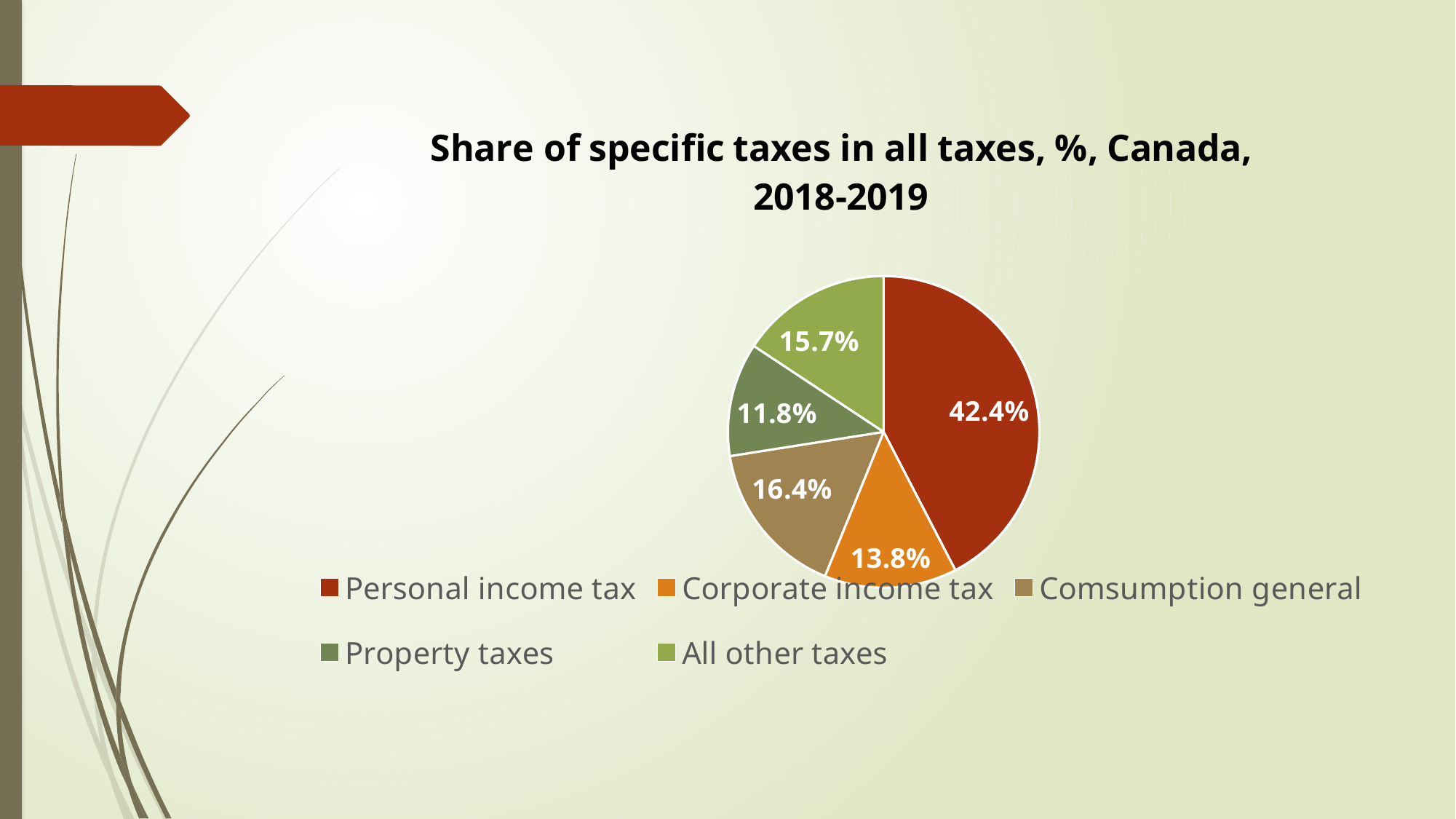
What is the share of Personal income tax? 42.4% What is the share of Corporate income tax? 13.8% What is the difference in percentage points between Personal income tax and Corporate income tax? 28.6 What is the share of All other taxes? 15.7% How many slices does the pie chart have? 5 What kind of chart is shown on the slide? pie chart What is the share of Comsumption general? 16.4% What is the title of the chart? Share of specific taxes in all taxes, %, Canada, 2018-2019 Which tax category has the smallest share? Property taxes Which has a larger share, Comsumption general or All other taxes? Comsumption general Which tax category has the largest share? Personal income tax What is the share of Property taxes? 11.8%